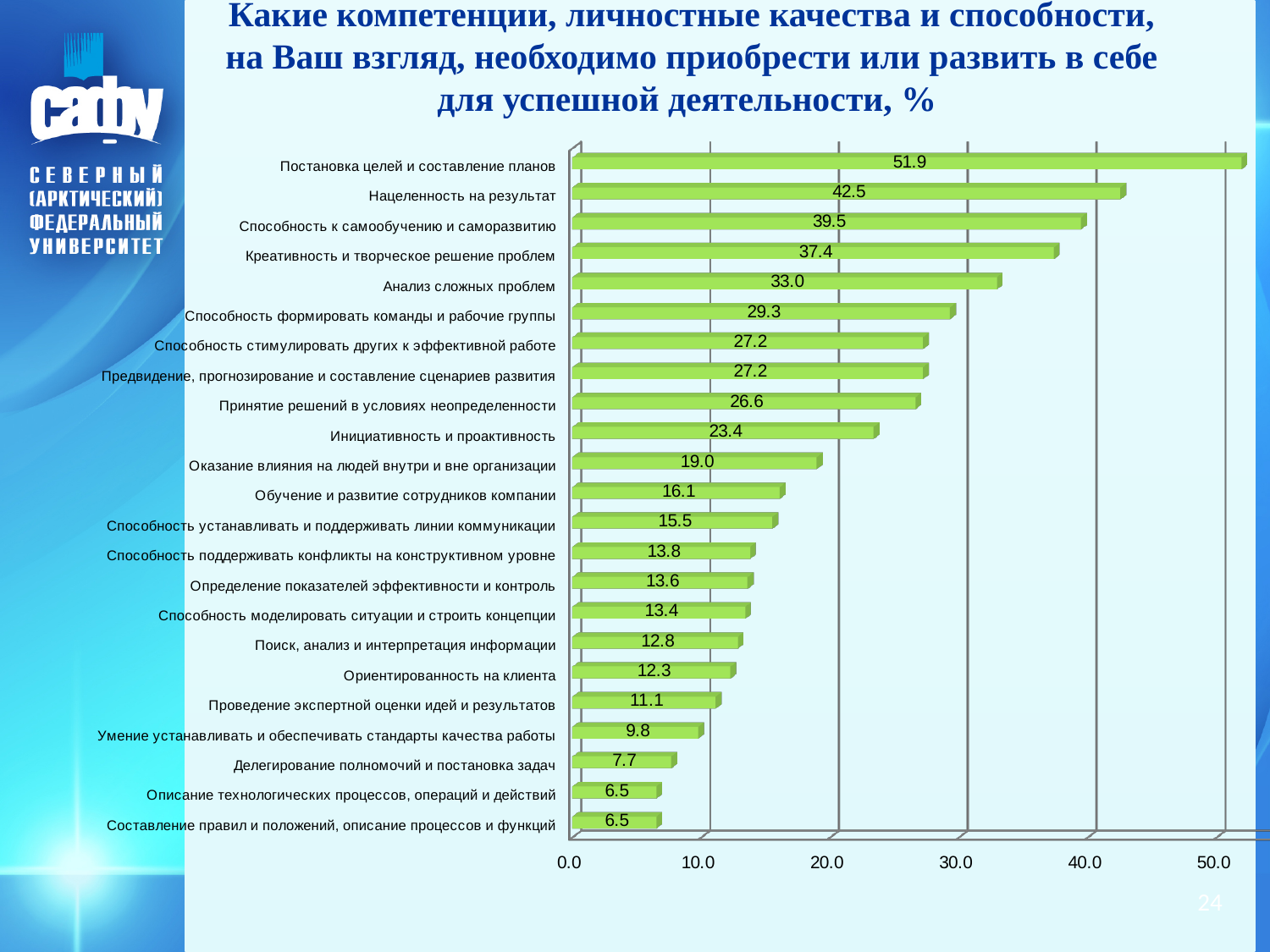
What is the value for «Ориентированность на клиента»? 12.3 What is the value for «Анализ сложных проблем»? 33.0 What is the highest tick value shown on the horizontal axis? 50.0 What type of chart is shown on the slide? Bar chart Is the value for «Креативность и творческое решение проблем» greater or less than 30.0? greater Which category has the highest value? Постановка целей и составление планов How many categories are shown in the chart? 23 What is the value for «Делегирование полномочий и постановка задач»? 7.7 What is the value for «Постановка целей и составление планов»? 51.9 Which is larger: the value for «Анализ сложных проблем» or for «Инициативность и проактивность»? Анализ сложных проблем Do the bar values increase or decrease going from the top of the chart to the bottom? Decrease What is the difference between the values for «Постановка целей и составление планов» and «Нацеленность на результат»? 9.4